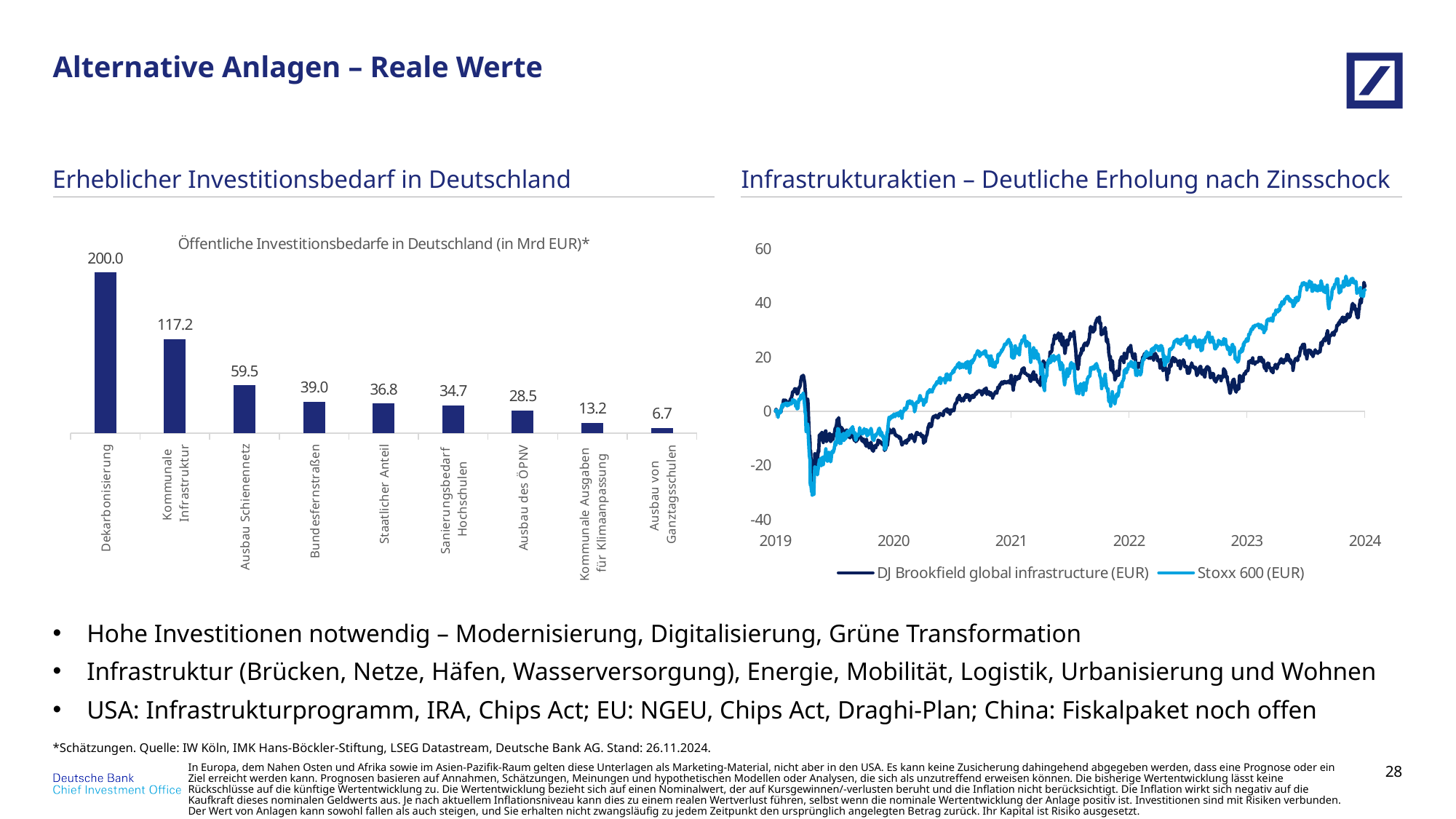
In the chart 'Öffentliche Investitionsbedarfe in Deutschland (in Mrd EUR)', what is the value for Kommunale Infrastruktur? 117.2 In the chart 'Öffentliche Investitionsbedarfe in Deutschland (in Mrd EUR)', which category has the lowest value? Ausbau von Ganztagsschulen How many series does the legend of the right chart 'Infrastrukturaktien – Deutliche Erholung nach Zinsschock' list? 2 What kind of chart is the right chart 'Infrastrukturaktien – Deutliche Erholung nach Zinsschock'? Line chart In the chart 'Öffentliche Investitionsbedarfe in Deutschland (in Mrd EUR)', what is the difference between Dekarbonisierung and Kommunale Infrastruktur? 82.8 In the chart 'Öffentliche Investitionsbedarfe in Deutschland (in Mrd EUR)', what is the value for Ausbau des ÖPNV? 28.5 In the chart 'Öffentliche Investitionsbedarfe in Deutschland (in Mrd EUR)', which is larger: Bundesfernstraßen or Staatlicher Anteil? Bundesfernstraßen What kind of chart is the left chart 'Öffentliche Investitionsbedarfe in Deutschland (in Mrd EUR)'? Bar chart In the chart 'Öffentliche Investitionsbedarfe in Deutschland (in Mrd EUR)', which category has the highest value? Dekarbonisierung How many categories are shown in the chart 'Öffentliche Investitionsbedarfe in Deutschland (in Mrd EUR)'? 9 In the chart 'Öffentliche Investitionsbedarfe in Deutschland (in Mrd EUR)', what is the value for Dekarbonisierung? 200.0